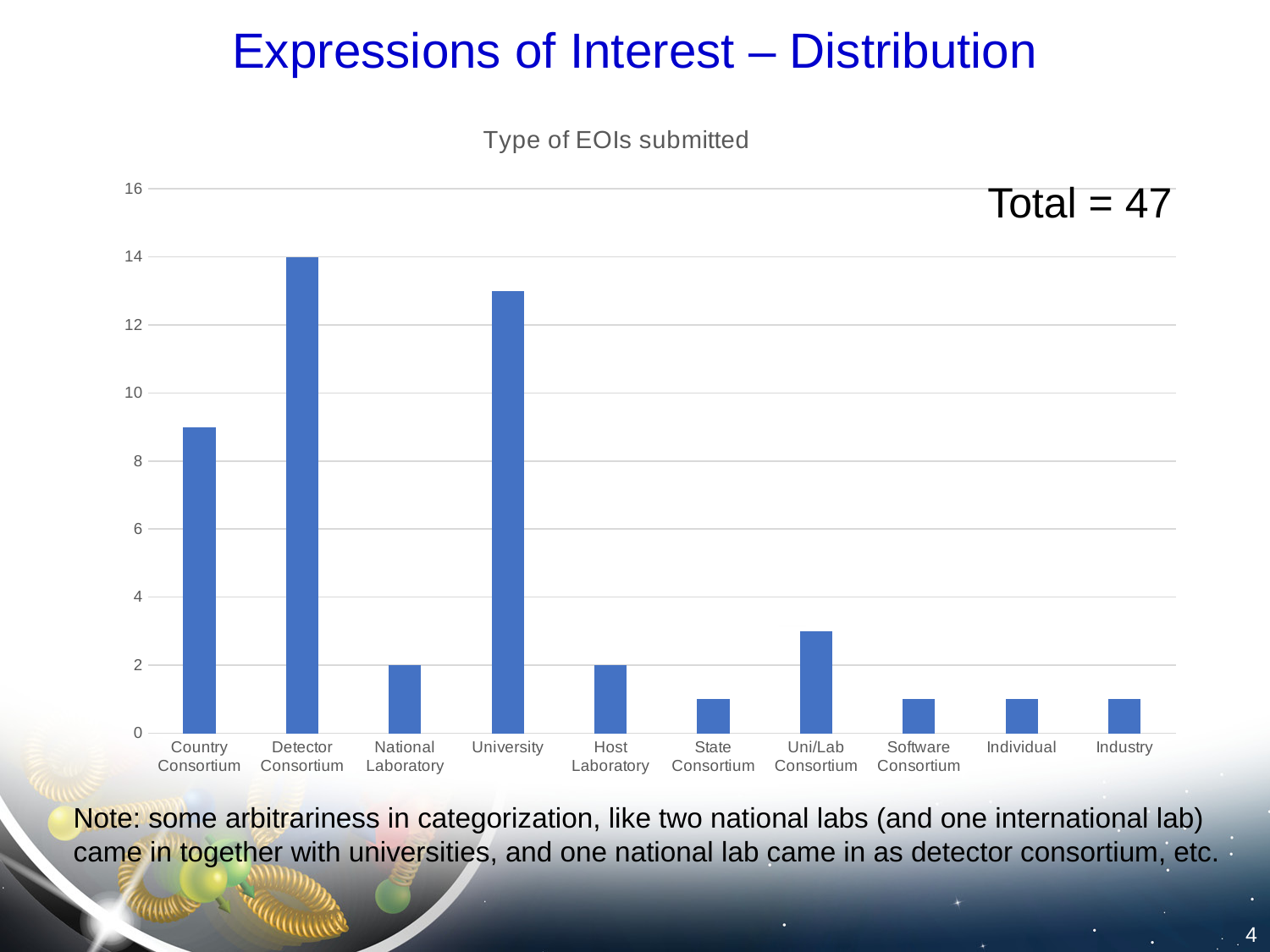
Is the value for Uni/Lab Consortium greater or less than 2? greater How many categories are shown on the x axis of the chart? 10 Which is larger, the value for Country Consortium or the value for University? University What is the value for Host Laboratory? 2 What is the value for Detector Consortium? 14 What total number of EOIs is stated on the slide next to the chart? Total = 47 Which category has the highest number of EOIs submitted? Detector Consortium What type of chart is shown on the slide? bar chart Is the value for University greater or less than 14? less Is the value for Country Consortium greater or less than 8? greater What is the title of the chart? Type of EOIs submitted What is the value for National Laboratory? 2